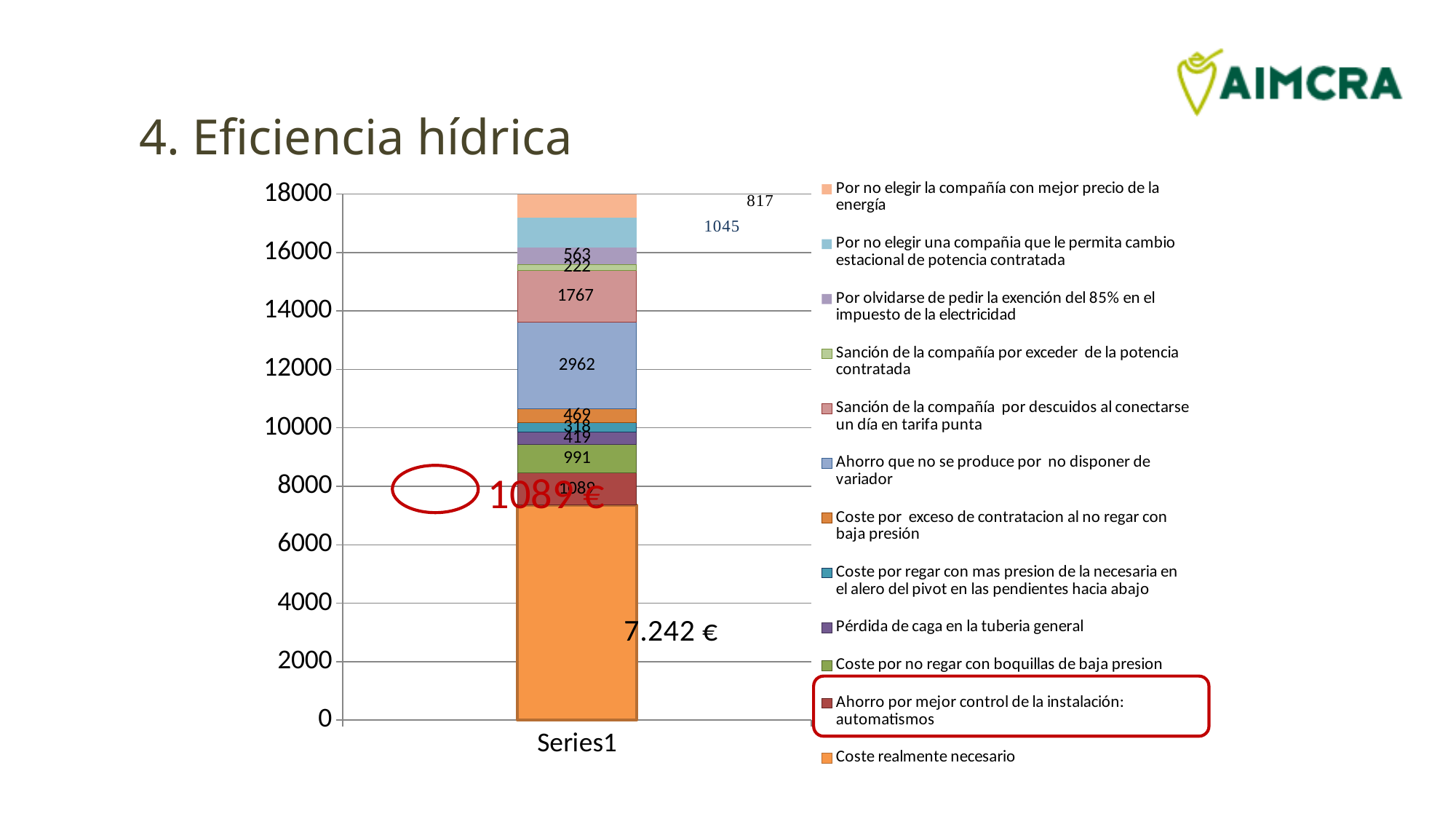
What is the value of the segment 'Ahorro por mejor control de la instalación: automatismos'? 1089 What is the value of the segment 'Ahorro que no se produce por no disponer de variador'? 2962 How many bars (categories) are plotted on the x axis? 1 Which segment of the stacked bar is the largest? Coste realmente necesario What is the difference between the 'variador' segment (2962) and the 'descuidos al conectarse' segment (1767)? 1195 Which is larger: the 'variador' segment (2962) or the 'descuidos al conectarse' segment (1767)? Ahorro que no se produce por no disponer de variador What is the label shown on the x axis under the bar? Series1 What value is labelled for the 'Coste realmente necesario' segment? 7.242 € What is the value of the segment 'Coste por no regar con boquillas de baja presion'? 991 How many series does the legend list? 12 What kind of chart is shown on the slide? Stacked bar chart What is the value of the segment 'Sanción de la compañía por descuidos al conectarse un día en tarifa punta'? 1767